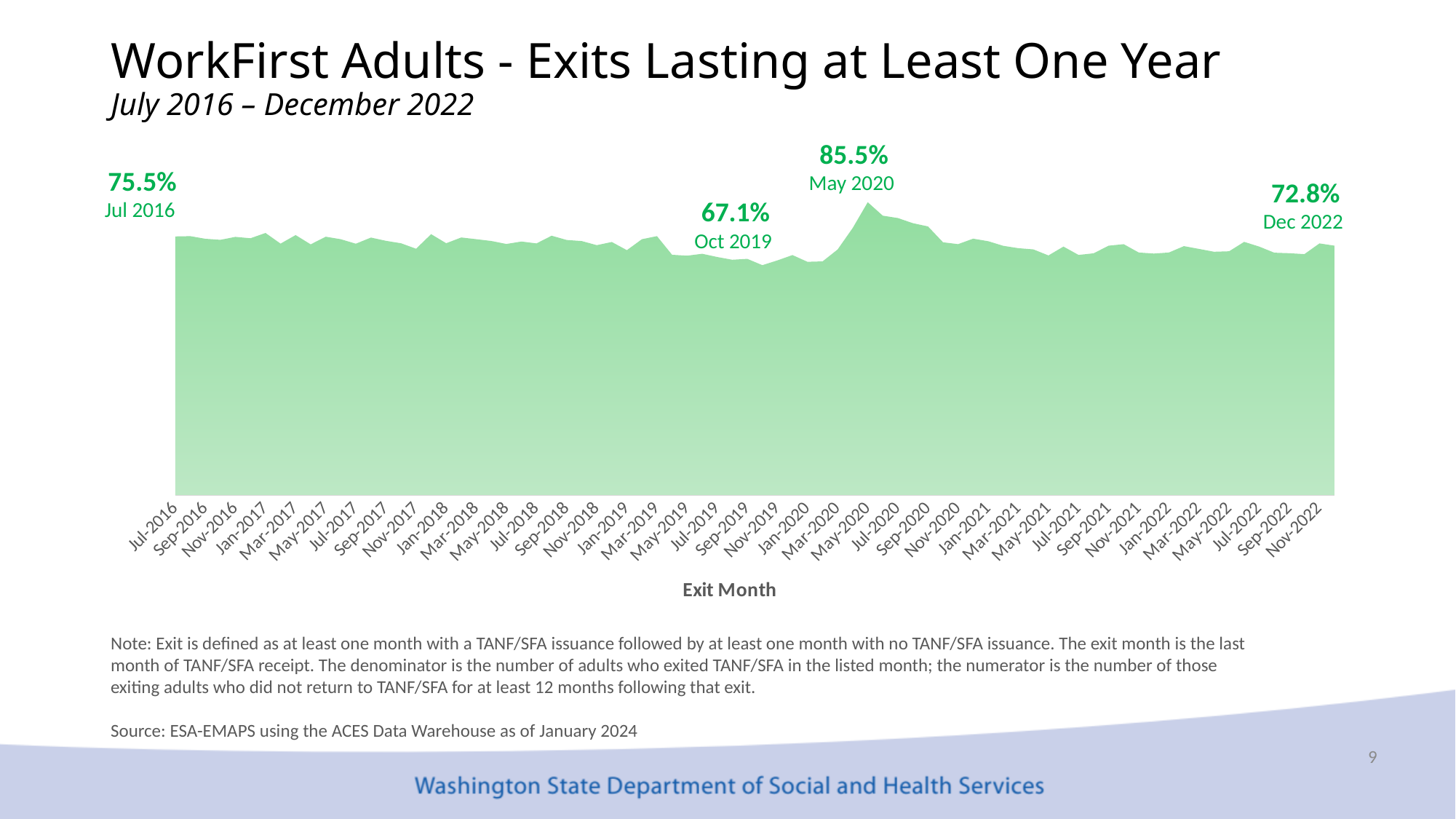
Which is larger, the value for Jul 2016 or the value for Dec 2022? Jul 2016 What value is labeled for Jul 2016? 75.5% What kind of chart is shown on the slide? Area chart What is the difference between the Jul 2016 value and the Dec 2022 value? 2.7 percentage points Which of the labeled months has the lowest value? Oct 2019 Do the values rise or fall between Oct 2019 and May 2020? Rise What value is labeled for Oct 2019? 67.1% What is the difference between the May 2020 value and the Oct 2019 value? 18.4 percentage points What is the title of the x axis? Exit Month What value is labeled for May 2020? 85.5% Which month has the highest value on the chart? May 2020 What value is labeled for Dec 2022? 72.8%